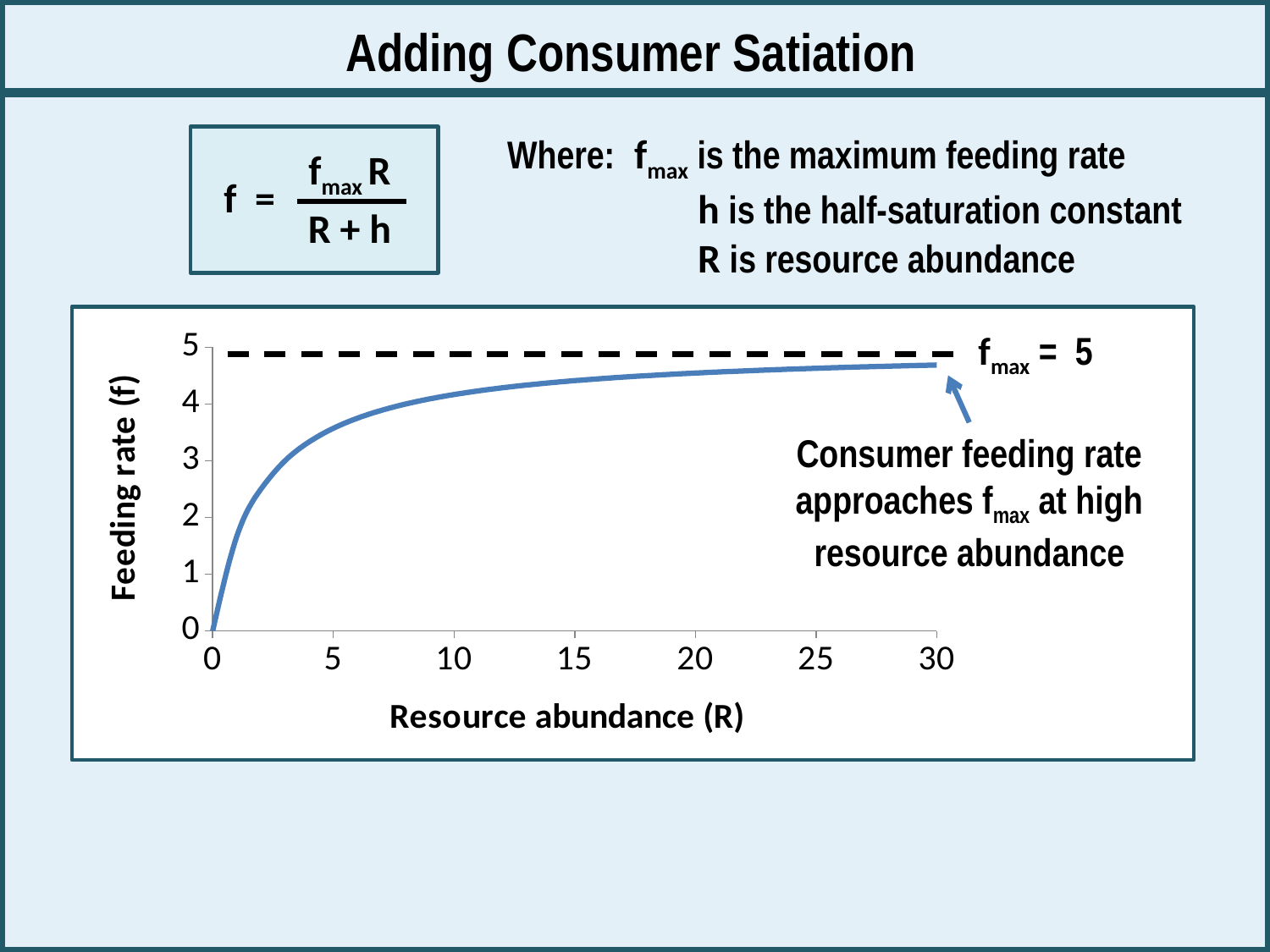
Is the feeding rate at a resource abundance of 20 greater or less than 4? greater Does the feeding rate rise or fall as resource abundance increases along the x axis? rises Is the feeding rate at a resource abundance of 30 greater or less than 5? less What is the label of the x axis of the chart? Resource abundance (R) What is the feeding rate when resource abundance is 0? 0 Is the feeding rate at a resource abundance of 5 greater or less than 3? greater How many tick marks are labelled on the x axis of the chart? 7 What is the label of the y axis of the chart? Feeding rate (f) What kind of chart is shown on the slide? line chart What value does the dashed horizontal line in the chart represent? f_max = 5 What is the highest value shown on the x axis of the chart? 30